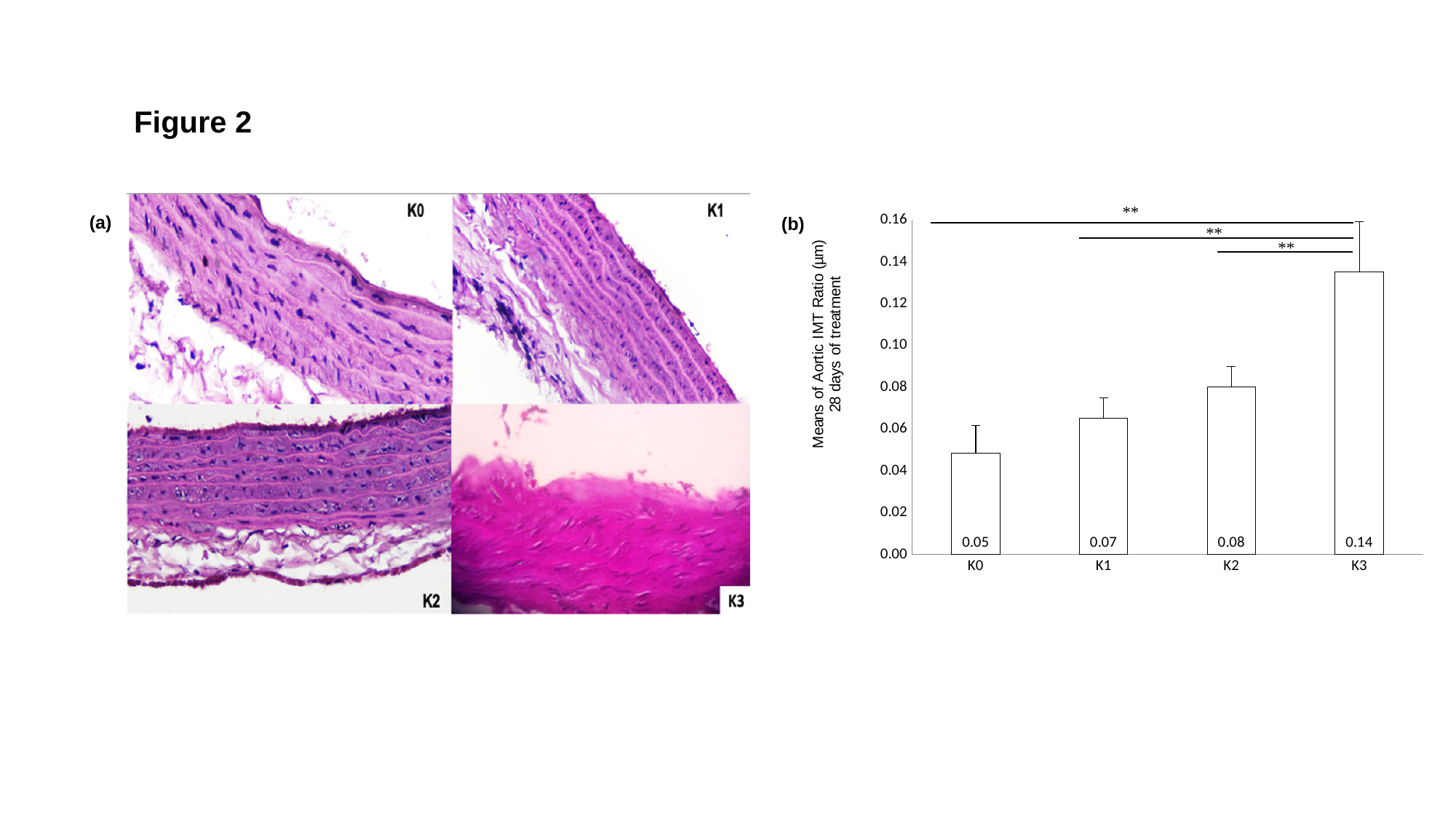
What kind of chart is panel (b)? bar chart In the bar chart (b), what is the value for K3? 0.14 In the bar chart (b), which is larger, the value for K1 or the value for K3? K3 In the bar chart (b), which group has the highest value? K3 How many groups are shown on the x axis of the bar chart (b)? 4 In the bar chart (b), which group has the lowest value? K0 In the bar chart (b), what is the value for K2? 0.08 In the bar chart (b), what is the difference between the values for K3 and K0? 0.09 In the bar chart (b), is the value for K3 greater or less than 0.10? greater In the bar chart (b), what is the value for K0? 0.05 In the bar chart (b), what is the value for K1? 0.07 In the bar chart (b), do the values rise or fall from K0 to K3? rise